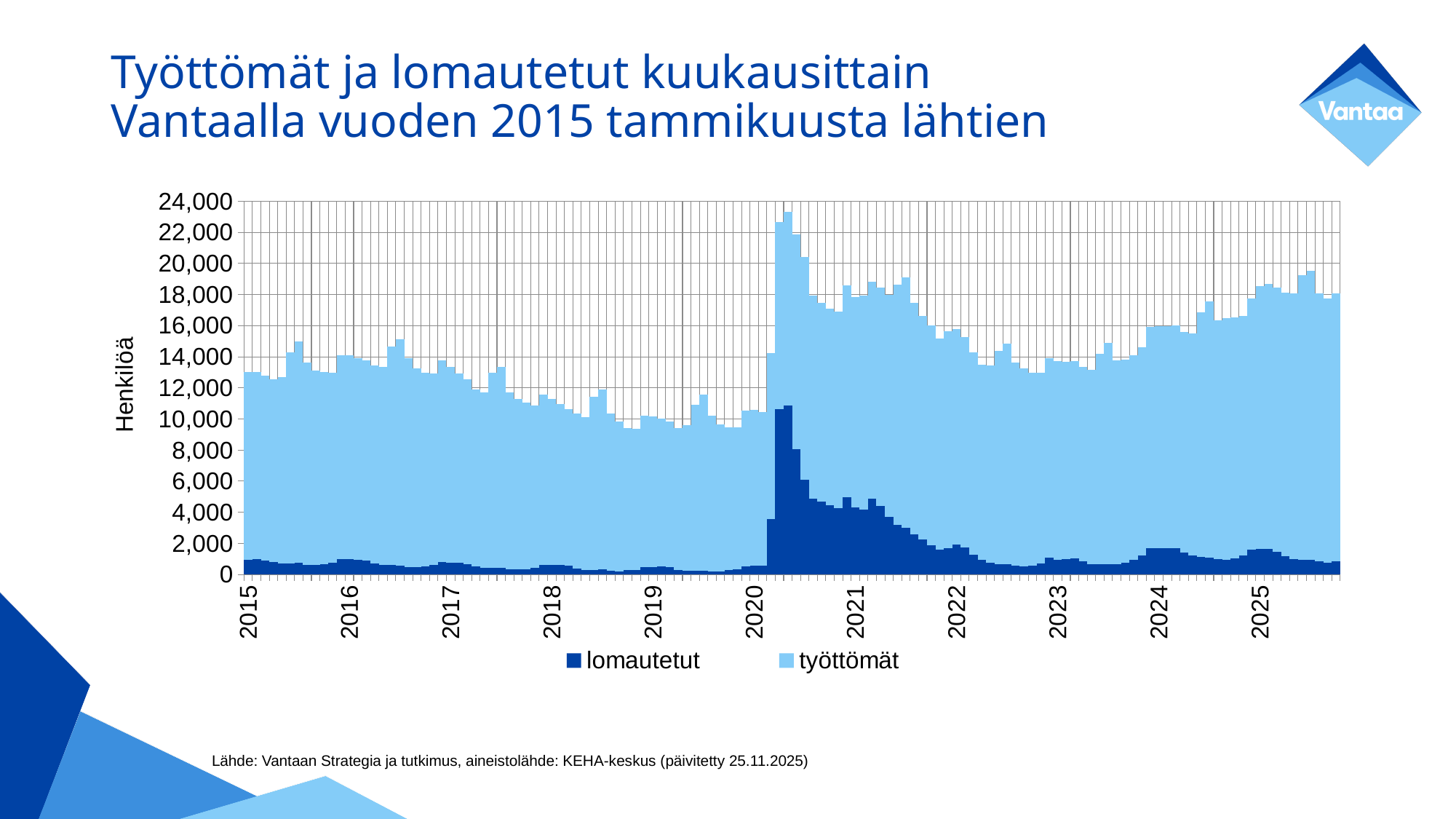
In which year does the stacked total reach its highest peak? 2020 How many series does the chart legend list? 2 Which series is larger in 2023, lomautetut or työttömät? työttömät Is the stacked total at the end of 2025 greater or less than 16,000? greater Is the highest stacked total in 2020 greater or less than 22,000? greater What kind of chart is shown on the slide? Stacked bar chart Is the value of lomautetut during 2018 greater or less than 2,000? less What is the label on the vertical axis of the chart? Henkilöä Does the stacked total rise or fall from 2022 to 2025? rise Which two series are listed in the chart legend? lomautetut and työttömät